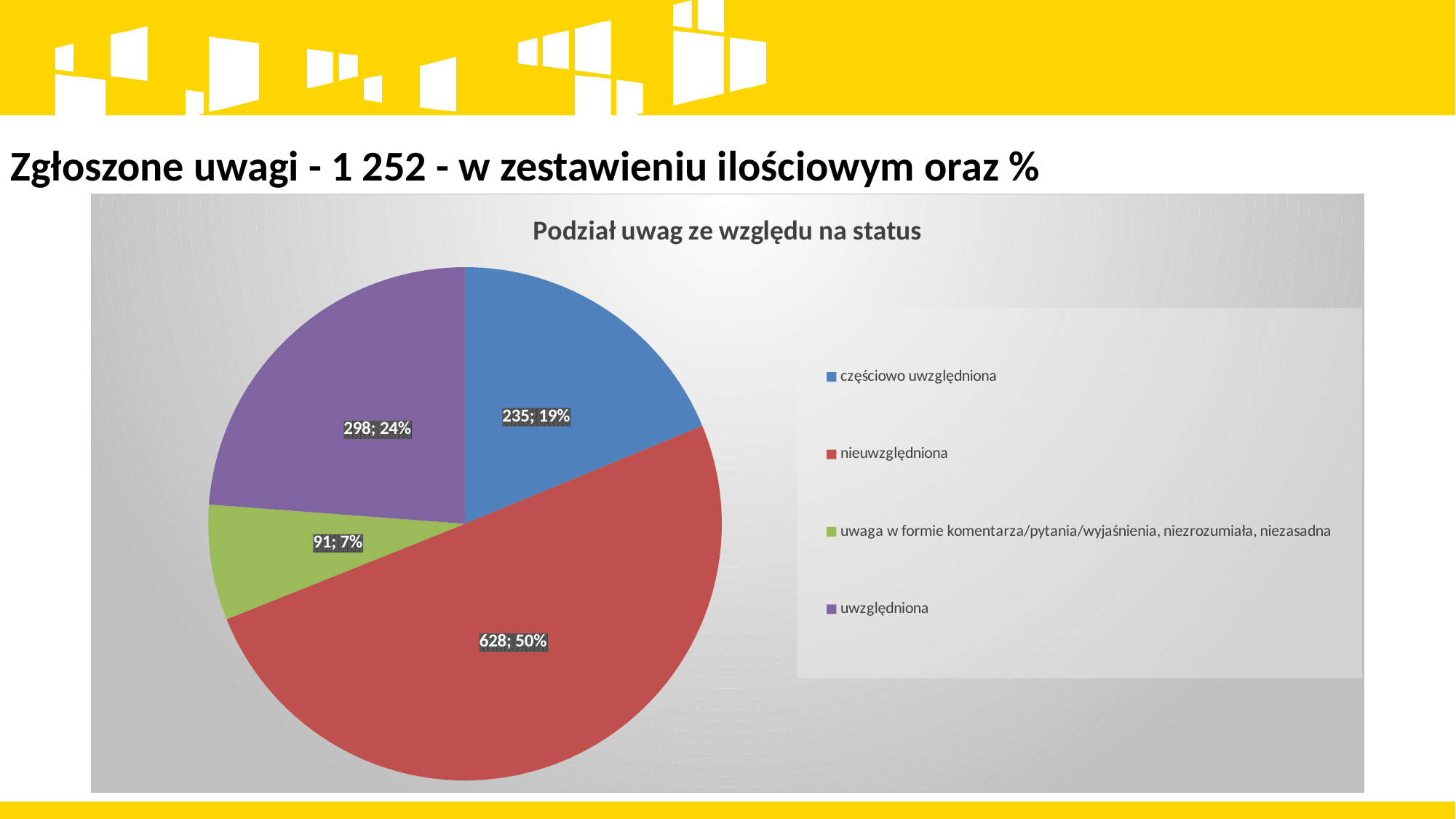
What is the title of the chart? Podział uwag ze względu na status What is the count for "częściowo uwzględniona"? 235 What is the count for "uwaga w formie komentarza/pytania/wyjaśnienia, niezrozumiała, niezasadna"? 91 What is the difference between the counts for "uwzględniona" and "częściowo uwzględniona"? 63 Which category has the smallest slice? uwaga w formie komentarza/pytania/wyjaśnienia, niezrozumiała, niezasadna How many slices does the pie chart have? 4 Which category has the largest slice? nieuwzględniona What kind of chart is shown on the slide? pie chart What share of the pie does "nieuwzględniona" represent? 50% What is the count for "uwzględniona"? 298 What share of the pie does "uwzględniona" represent? 24% What is the count for "nieuwzględniona"? 628